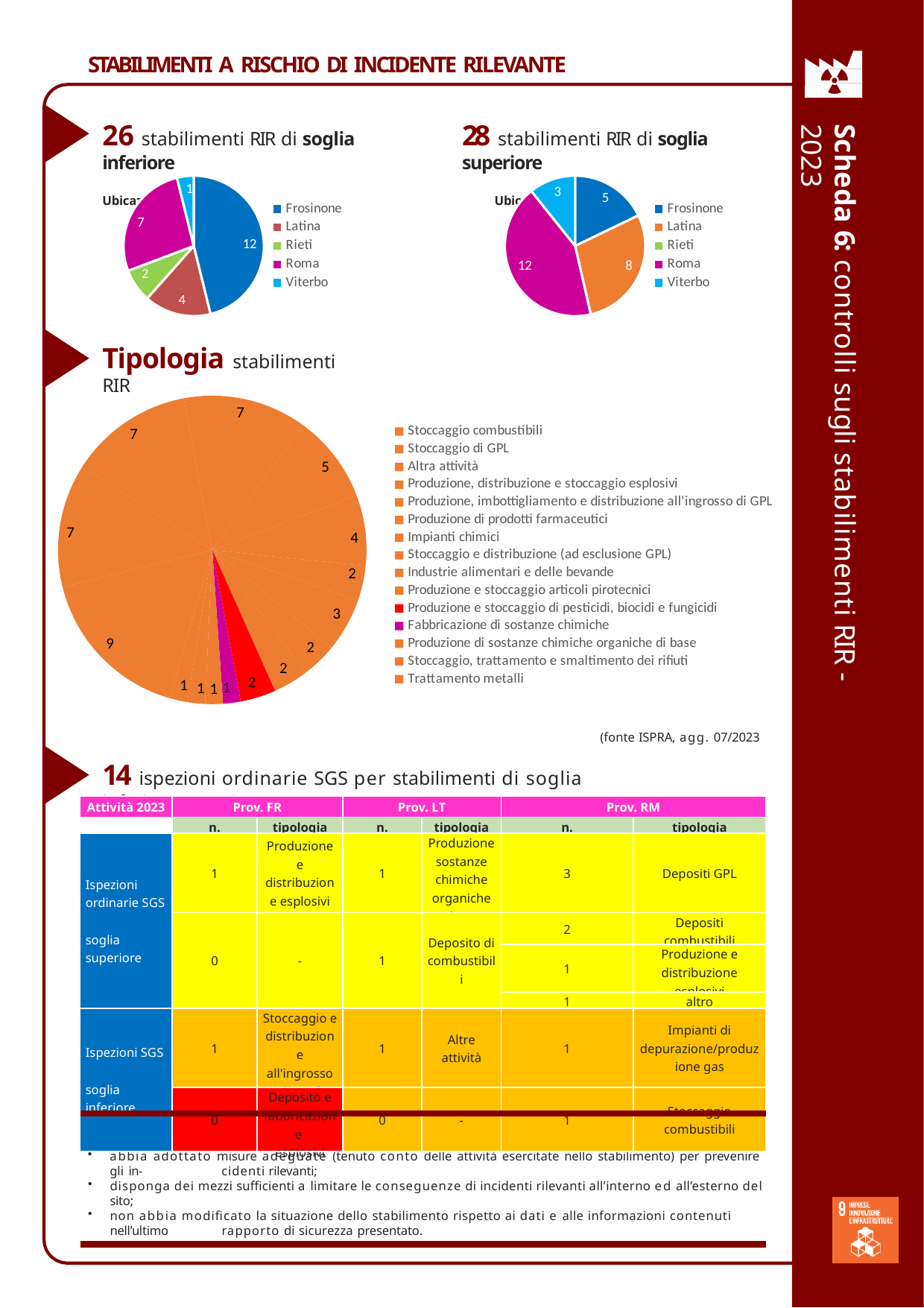
In the pie chart '28 stabilimenti RIR di soglia superiore', which is larger, the value for Latina or the value for Frosinone? Latina In the pie chart '28 stabilimenti RIR di soglia superiore', what is the difference between the values for Latina and Frosinone? 3 In the pie chart '28 stabilimenti RIR di soglia superiore', which province has the largest slice? Roma In the pie chart '26 stabilimenti RIR di soglia inferiore', what is the value for Latina? 4 In the pie chart '28 stabilimenti RIR di soglia superiore', what is the value for Roma? 12 In the pie chart '28 stabilimenti RIR di soglia superiore', what is the value for Viterbo? 3 How many entries does the legend of the 'Tipologia stabilimenti RIR' pie chart list? 15 In the pie chart '26 stabilimenti RIR di soglia inferiore', what is the value for Frosinone? 12 What kind of chart is used for 'Tipologia stabilimenti RIR'? Pie chart How many provinces are listed in the legend of the pie chart '26 stabilimenti RIR di soglia inferiore'? 5 In the pie chart '26 stabilimenti RIR di soglia inferiore', which province has the smallest slice? Viterbo In the pie chart '26 stabilimenti RIR di soglia inferiore', what is the difference between the values for Frosinone and Roma? 5